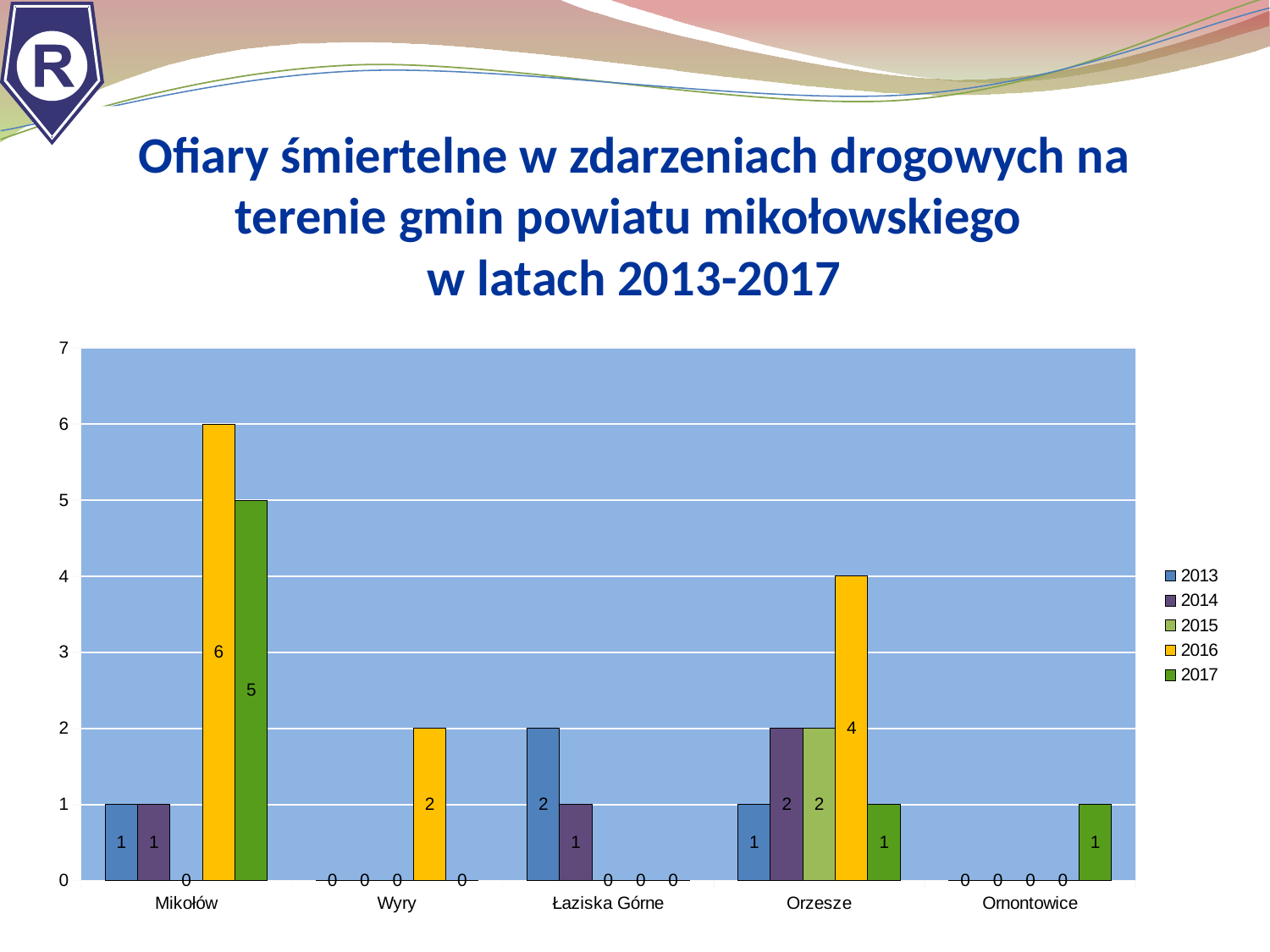
What is the value for Łaziska Górne in 2013? 2 How many series does the legend list? 5 What is the difference between the 2016 and 2017 values for Mikołów? 1 What is the value for Ornontowice in 2017? 1 What kind of chart is shown on the slide? bar chart What is the value for Orzesze in 2016? 4 What is the value for Mikołów in 2016? 6 Which municipality has the highest value in 2016? Mikołów How many municipalities (categories) are shown on the x axis? 5 Which year is shown in yellow in the legend? 2016 Which is larger: the 2016 value for Mikołów or the 2016 value for Orzesze? Mikołów What is the total of the values for Orzesze across all five years? 10